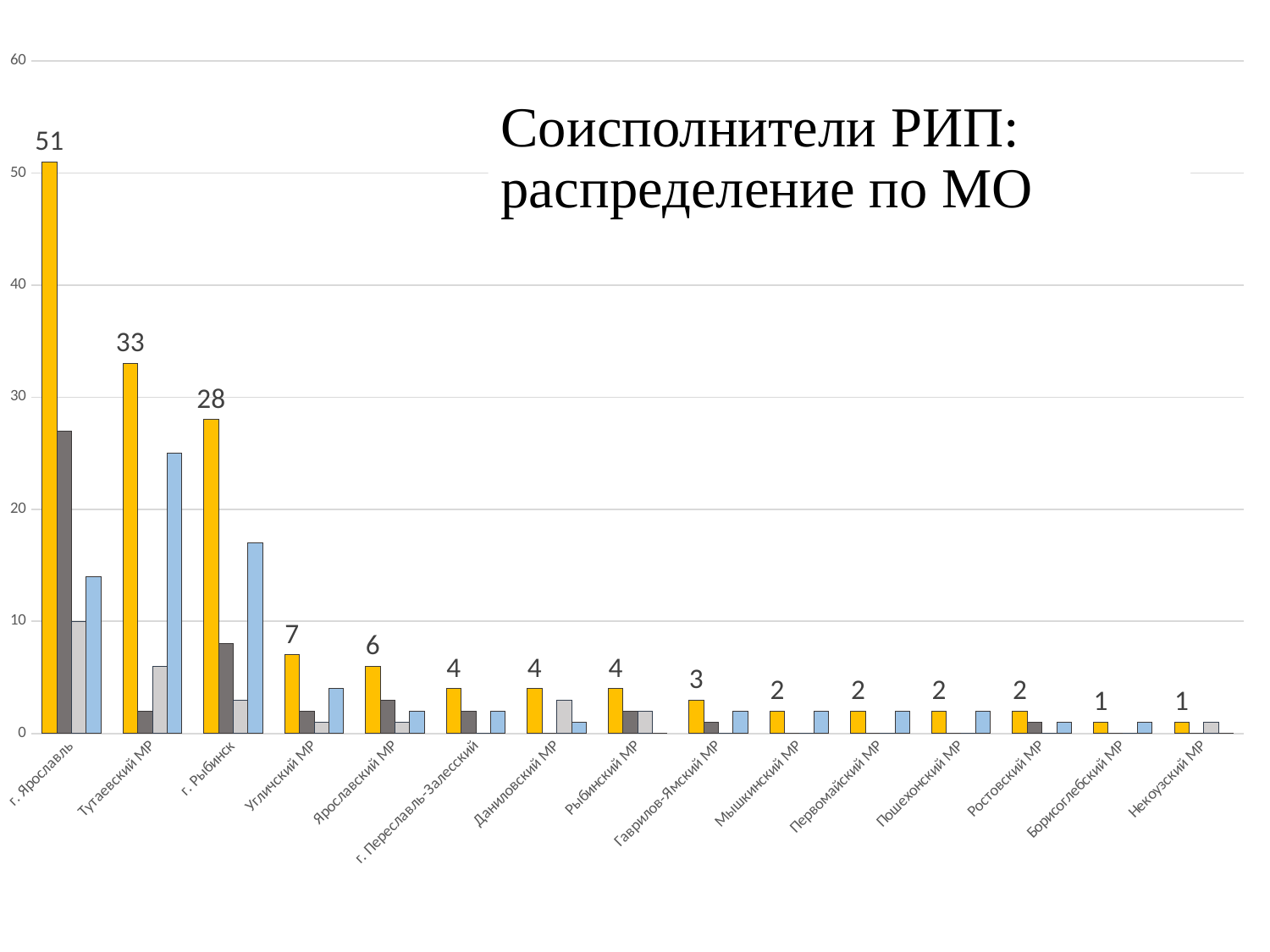
What kind of chart is shown on the slide? Bar chart Is the value of the dark gray bar for г. Ярославль greater or less than 30? less How many categories are shown on the x axis? 15 What is the value of the yellow bar for Тутаевский МР? 33 Is the value of the light blue bar for Тутаевский МР greater or less than 20? greater What is the title of the chart? Соисполнители РИП: распределение по МО Which has a larger yellow bar value, г. Рыбинск or Угличский МР? г. Рыбинск What is the value of the yellow bar for г. Рыбинск? 28 What is the value of the yellow bar for г. Ярославль? 51 What is the difference between the yellow bar values for г. Ярославль and Тутаевский МР? 18 What is the value of the yellow bar for Угличский МР? 7 Which category has the highest yellow bar? г. Ярославль